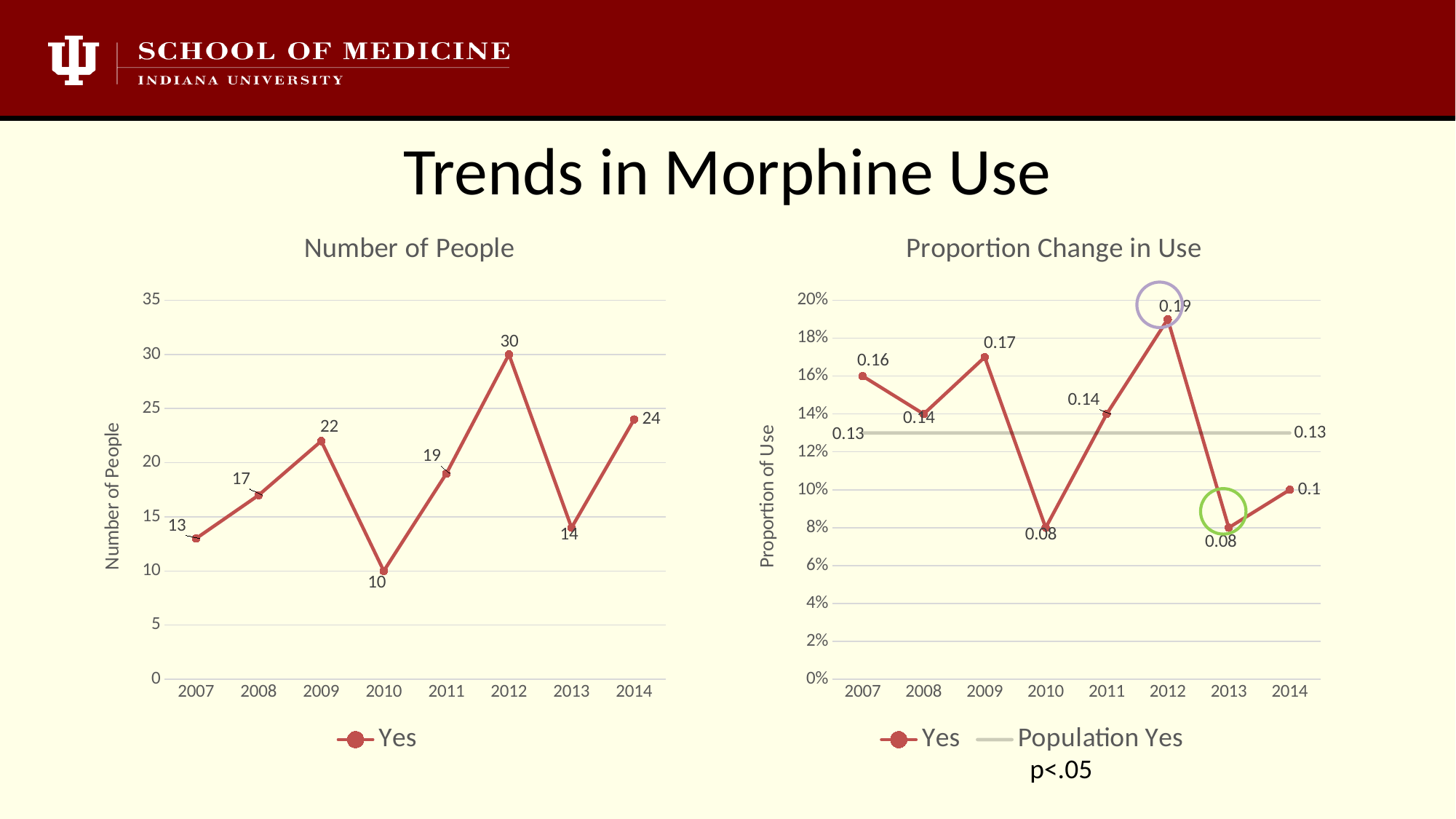
In the 'Proportion Change in Use' chart, how many series does the legend list? 2 In the 'Number of People' chart, does the value rise or fall from 2013 to 2014? Rise In the 'Proportion Change in Use' chart, what is the difference between the Yes values for 2012 and 2013? 0.11 In the 'Number of People' chart, what is the value for 2012? 30 In the 'Number of People' chart, how many years are plotted on the x axis? 8 In the 'Proportion Change in Use' chart, what is the value of the Yes series for 2012? 0.19 In the 'Number of People' chart, which year has the lowest value? 2010 In the 'Proportion Change in Use' chart, what is the value of the Population Yes line? 0.13 What kind of chart is the 'Number of People' chart? Line chart In the 'Number of People' chart, what is the difference between the values for 2012 and 2013? 16 In the 'Number of People' chart, is the value for 2009 larger than the value for 2011? Yes In the 'Number of People' chart, which year has the highest value? 2012